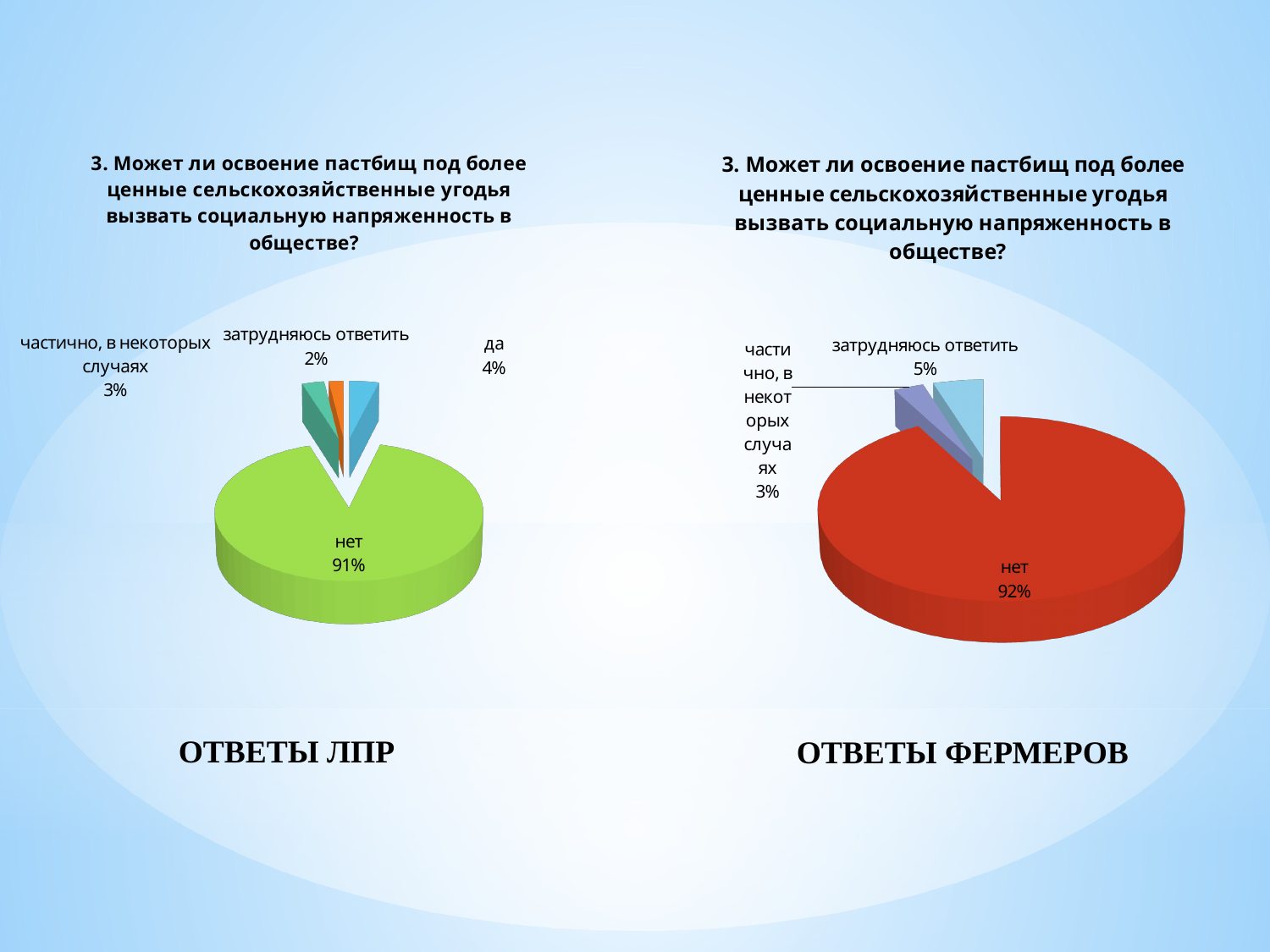
Which chart shows a larger share for "нет": the left chart (ОТВЕТЫ ЛПР) or the right chart (ОТВЕТЫ ФЕРМЕРОВ)? the right chart (ОТВЕТЫ ФЕРМЕРОВ) How many slices does the left chart (ОТВЕТЫ ЛПР) have? 4 On the left chart (ОТВЕТЫ ЛПР), what share of respondents answered "да"? 4% On the right chart (ОТВЕТЫ ФЕРМЕРОВ), what share of respondents answered "нет"? 92% What type of chart is used on the left side of the slide (ОТВЕТЫ ЛПР)? pie chart On the right chart (ОТВЕТЫ ФЕРМЕРОВ), what is the difference between the shares for "затрудняюсь ответить" and "частично, в некоторых случаях"? 2% On the left chart (ОТВЕТЫ ЛПР), what share of respondents answered "затрудняюсь ответить"? 2% On the left chart (ОТВЕТЫ ЛПР), which answer has the smallest share? затрудняюсь ответить On the right chart (ОТВЕТЫ ФЕРМЕРОВ), what share of respondents answered "затрудняюсь ответить"? 5% On the left chart (ОТВЕТЫ ЛПР), what is the difference between the shares for "нет" and "да"? 87% On the left chart (ОТВЕТЫ ЛПР), what share of respondents answered "нет"? 91% On the right chart (ОТВЕТЫ ФЕРМЕРОВ), which answer has the largest share? нет